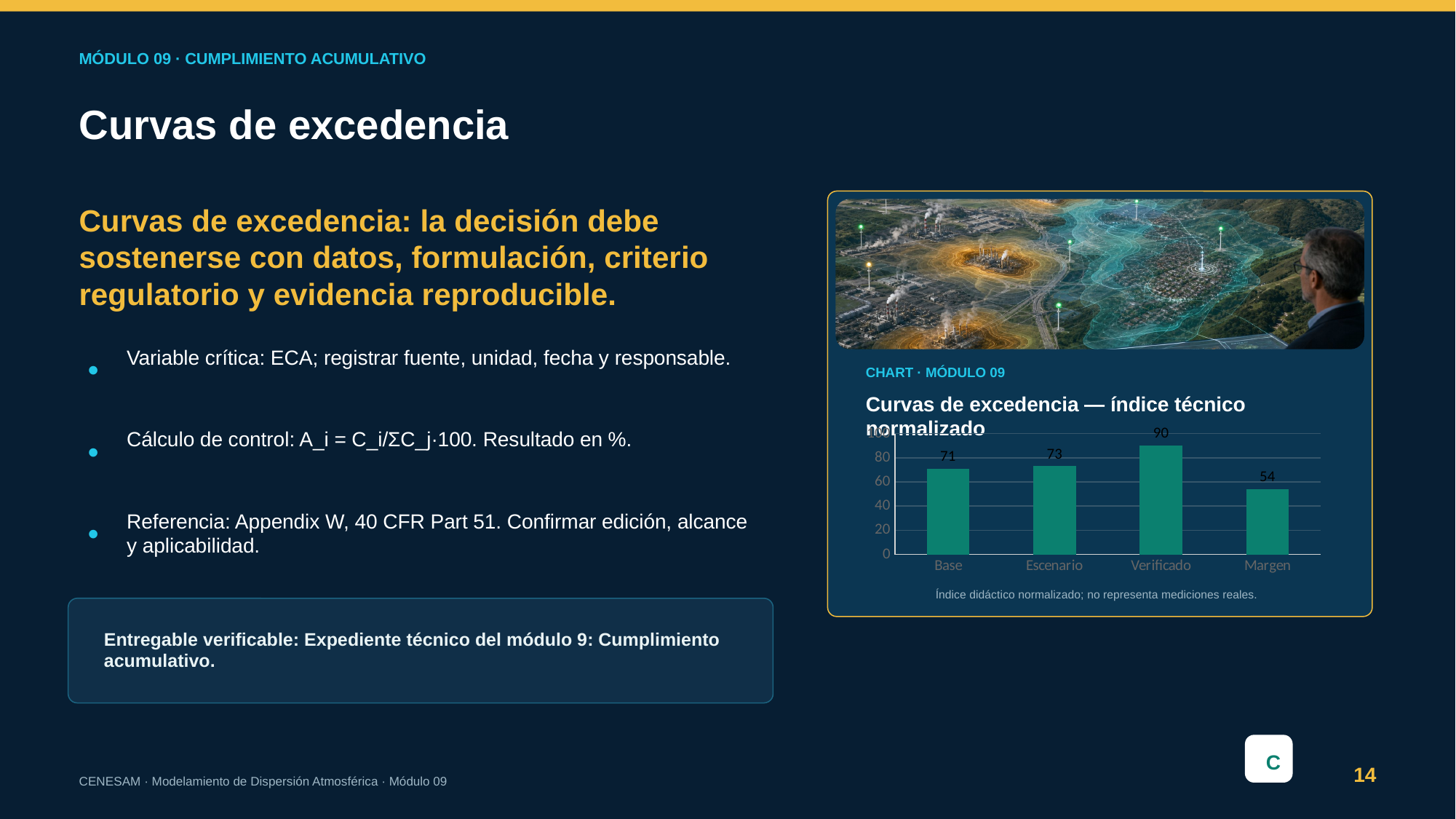
Which category has the highest value? Verificado How many categories are shown on the x axis? 4 Which is larger, the value for Base or the value for Margen? Base Which category has the lowest value? Margen What is the difference between the values for Verificado and Margen? 36 What is the value for Base? 71 Is the value for Margen greater or less than 60? less What kind of chart is shown? Bar chart What is the value for Escenario? 73 What is the value for Margen? 54 What is the value for Verificado? 90 What is the title of the chart? Curvas de excedencia — índice técnico normalizado